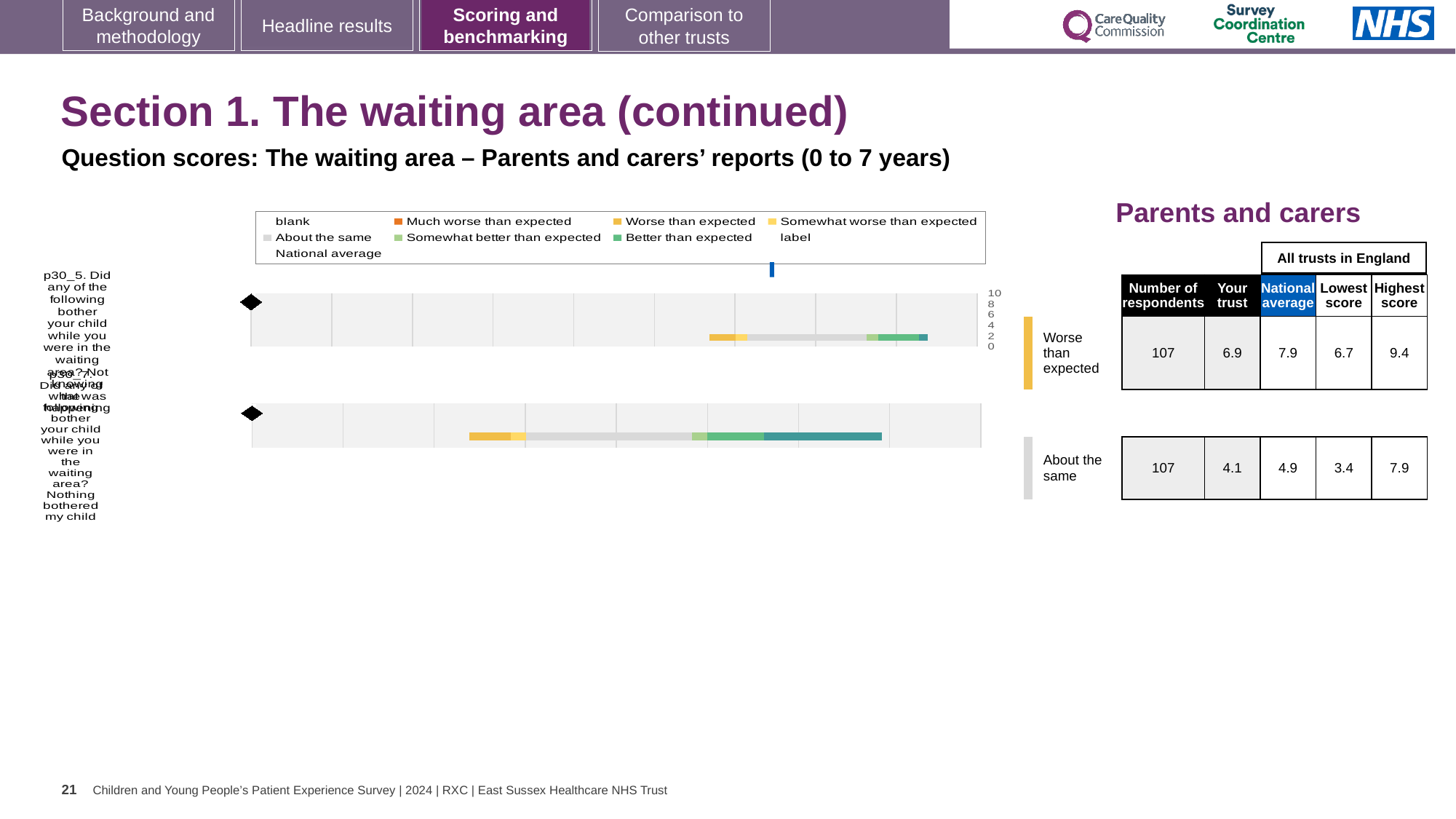
What is the difference between the highest score and the lowest score for the question rated 'Worse than expected'? 2.7 How many respondents are recorded for the question rated 'Worse than expected'? 107 How many bars (questions) are plotted in the chart? 2 What colour does the legend use for 'Much worse than expected'? Orange For the question rated 'Worse than expected', which is larger: the trust's score or the national average? National average How many entries does the chart legend list? 9 What is the national average score for the question rated 'About the same'? 4.9 Which is larger: the highest score for the 'Worse than expected' question or the highest score for the 'About the same' question? Worse than expected (9.4) What is the lowest score across all trusts in England for the question rated 'About the same'? 3.4 What is the 'Your trust' score for the question rated 'Worse than expected'? 6.9 For the question rated 'About the same', how much higher is the national average than the trust's score? 0.8 What kind of chart is shown on the slide? bar chart